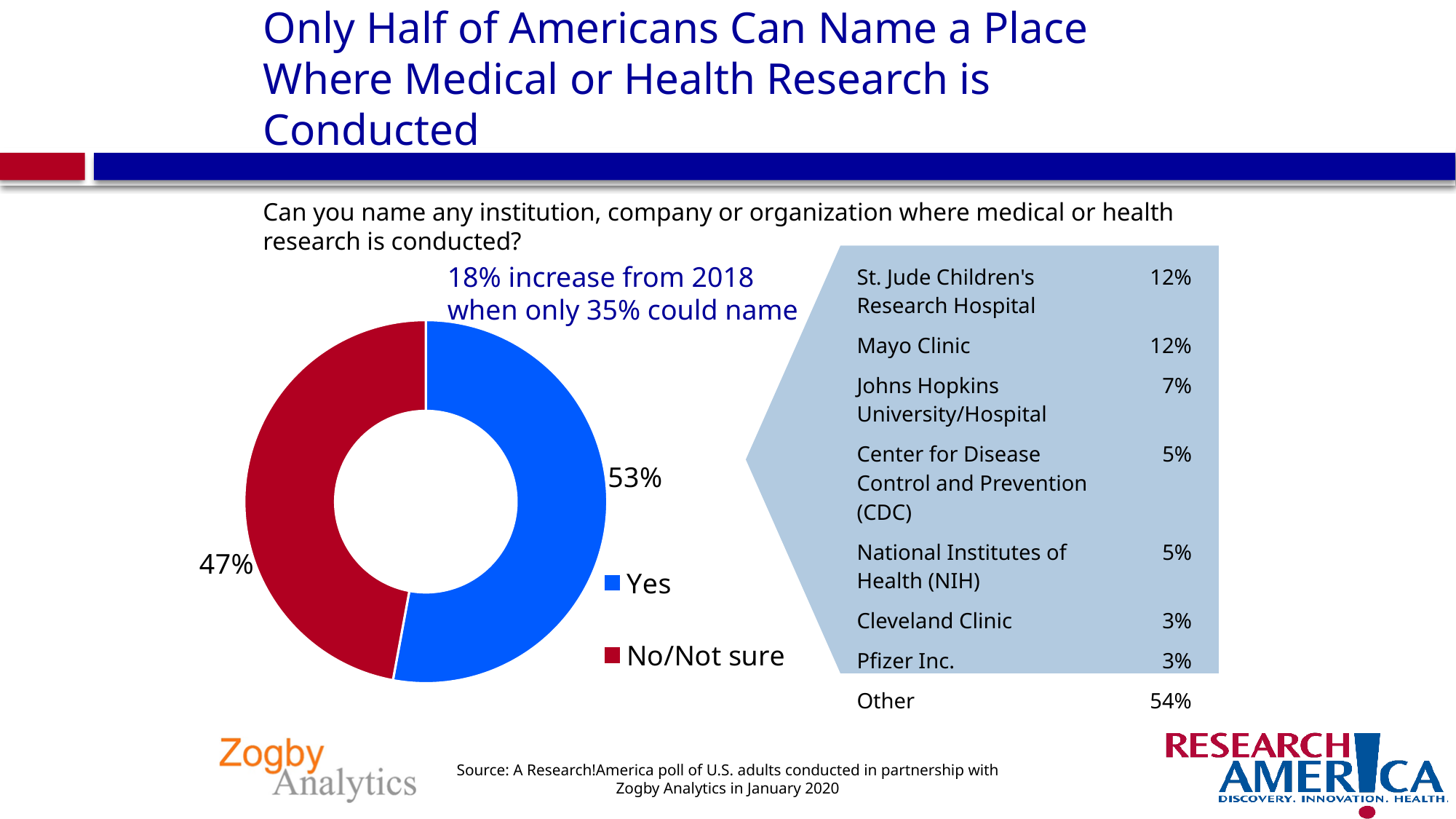
How many slices does the donut chart have? 2 What colour is the Yes slice in the donut chart? Blue What kind of chart is shown on the slide? Donut (pie) chart What percentage of respondents answered No/Not sure in the donut chart? 47% Is the Yes share in the donut chart greater or less than 50%? greater How many entries does the legend of the donut chart list? 2 According to the annotation on the chart, what percentage could name a place in 2018? 35% Which response has the larger share in the donut chart, Yes or No/Not sure? Yes What percentage of respondents answered Yes in the donut chart? 53% What is the difference in percentage points between the Yes and No/Not sure slices? 6% Which slice of the donut chart is the largest? Yes Which slice of the donut chart is the smallest? No/Not sure